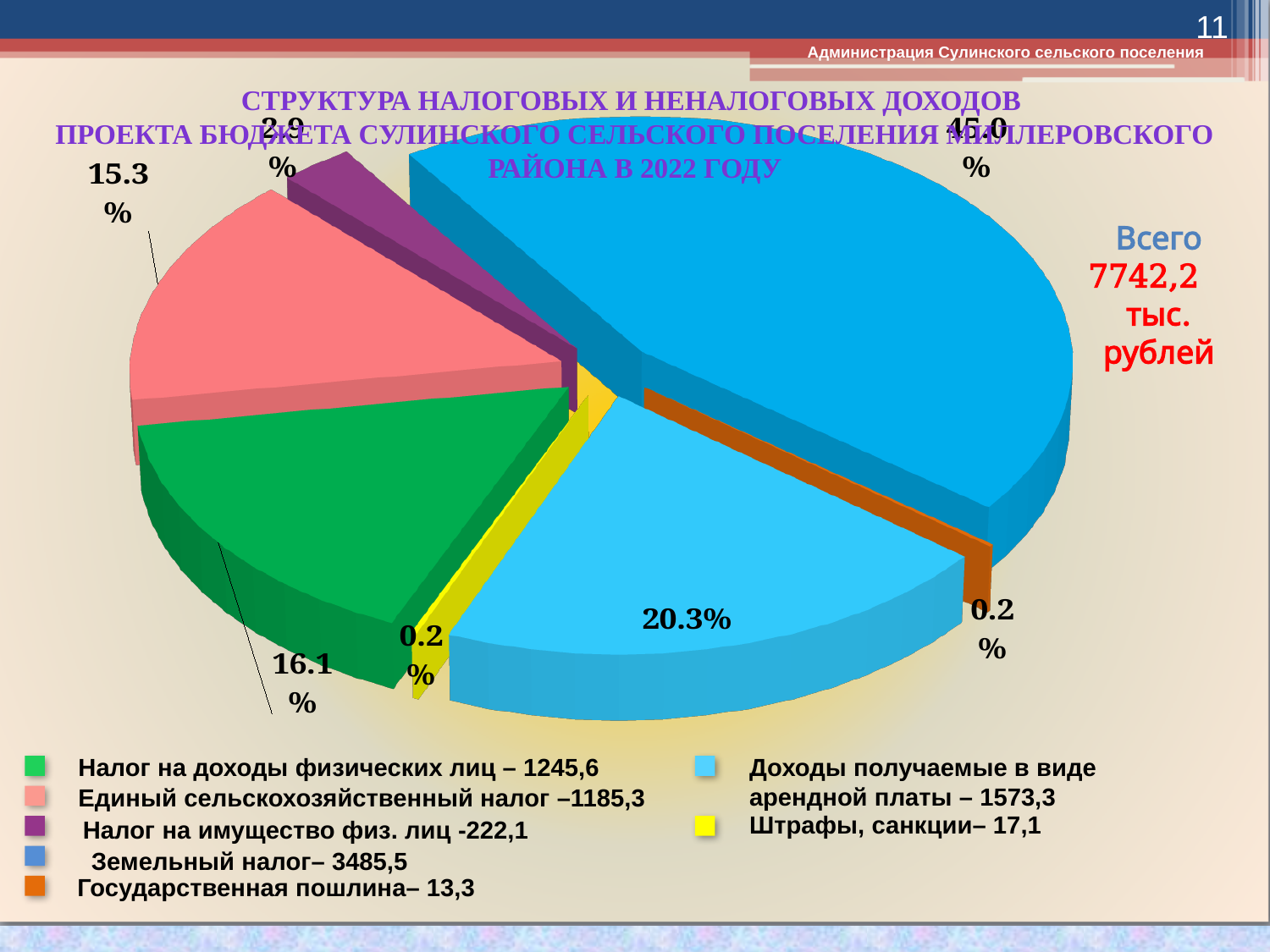
What is the value for Земельный налог given in the legend? 3485,5 What kind of chart is shown on the slide? pie chart What share of the pie does Единый сельскохозяйственный налог (the pink slice) represent? 15.3% What is the value for Штрафы, санкции given in the legend? 17,1 What share of the pie does Налог на доходы физических лиц (the green slice) represent? 16.1% What share of the pie does Земельный налог (the blue slice) represent? 45.0% Which category has the largest slice of the pie? Земельный налог How many categories does the legend list? 7 What total amount (Всего) is stated next to the pie chart? 7742,2 тыс. рублей Which is larger: the slice for Налог на доходы физических лиц or the slice for Единый сельскохозяйственный налог? Налог на доходы физических лиц